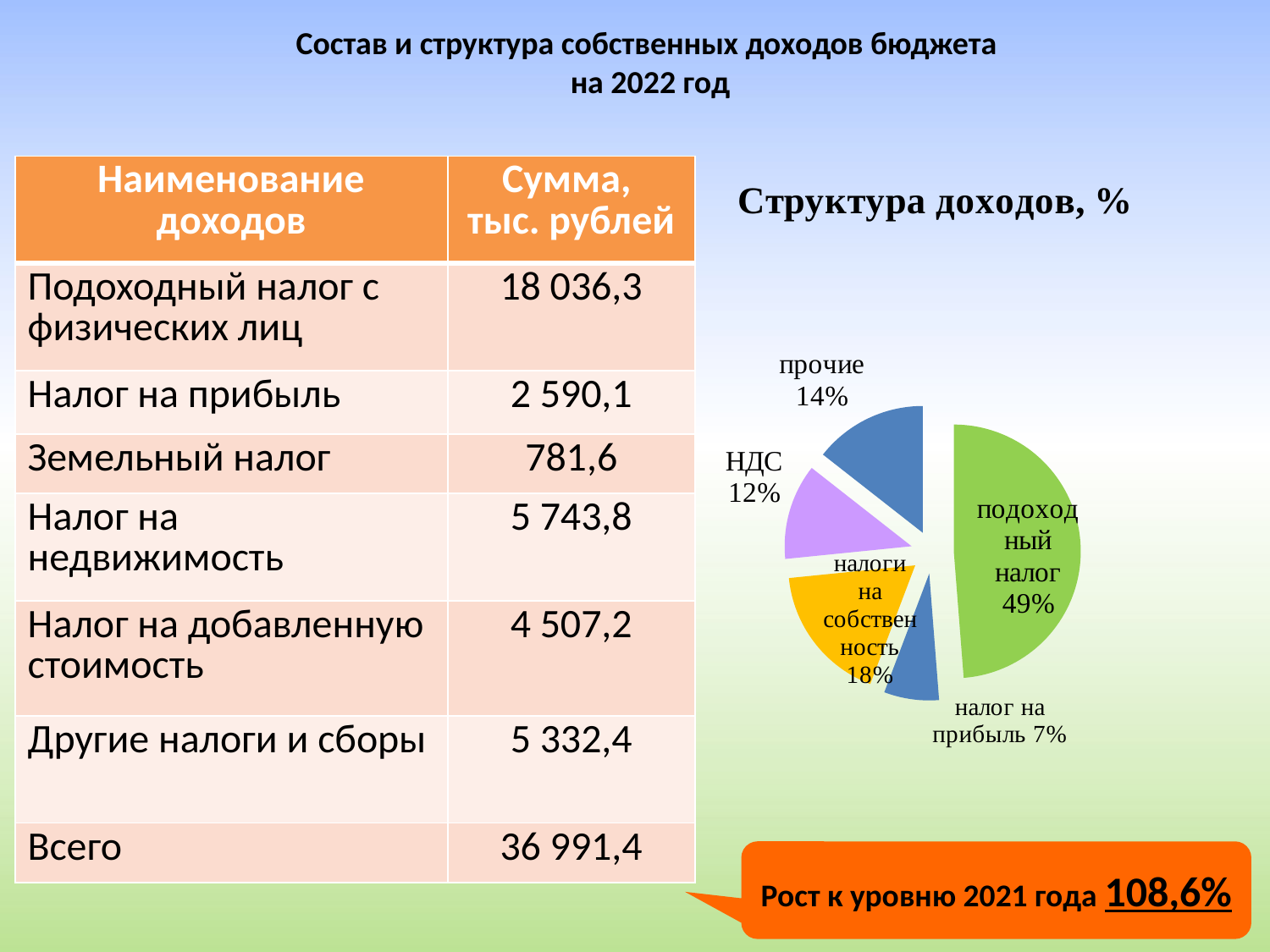
What type of chart is shown under the title "Структура доходов, %"? pie chart In the pie chart "Структура доходов, %", what share does "налоги на собственность" have? 18% Which slice of the pie chart "Структура доходов, %" is the largest? подоходный налог In the pie chart "Структура доходов, %", what share does "подоходный налог" have? 49% How many slices does the pie chart "Структура доходов, %" have? 5 In the pie chart "Структура доходов, %", what share does "НДС" have? 12% Which slice of the pie chart "Структура доходов, %" is the smallest? налог на прибыль In the pie chart "Структура доходов, %", what is the difference in percentage points between "налоги на собственность" and "НДС"? 6 In the pie chart "Структура доходов, %", what share does "прочие" have? 14% In the pie chart "Структура доходов, %", what share does "налог на прибыль" have? 7% In the pie chart "Структура доходов, %", which is larger: "прочие" or "НДС"? прочие What is the title of the pie chart on the slide? Структура доходов, %